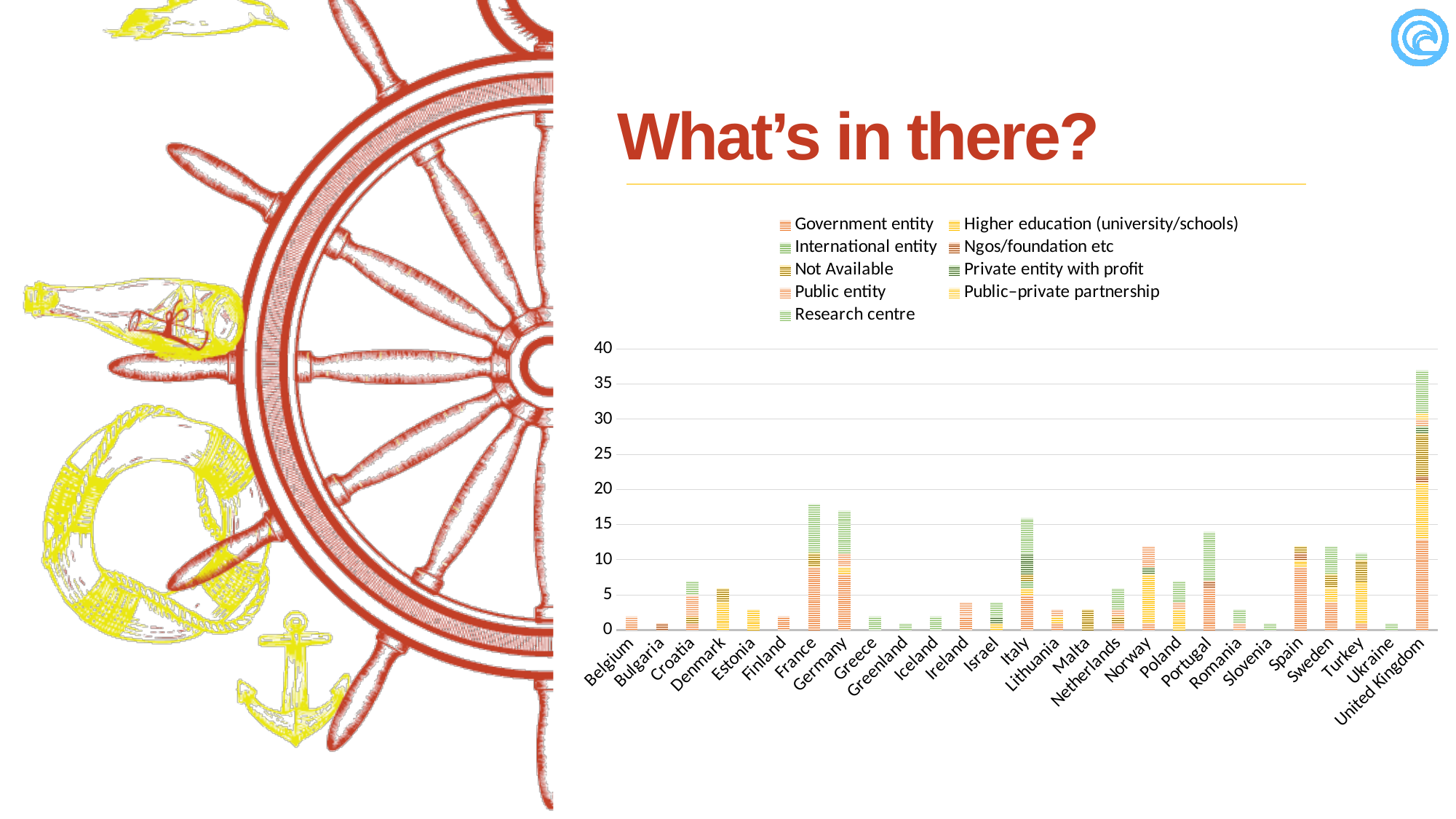
What is the title of the slide containing the chart? What's in there? What kind of chart is shown on the slide? bar chart Which country has the highest total bar in the chart? United Kingdom How many series does the legend list? 9 Which has the larger total bar, France or Belgium? France Which has the larger total bar, United Kingdom or Germany? United Kingdom Is the total value for Poland greater or less than 5? greater Is the total value for United Kingdom greater or less than 30? greater Is the total value for Norway greater or less than 10? greater How many countries are shown on the x axis of the chart? 27